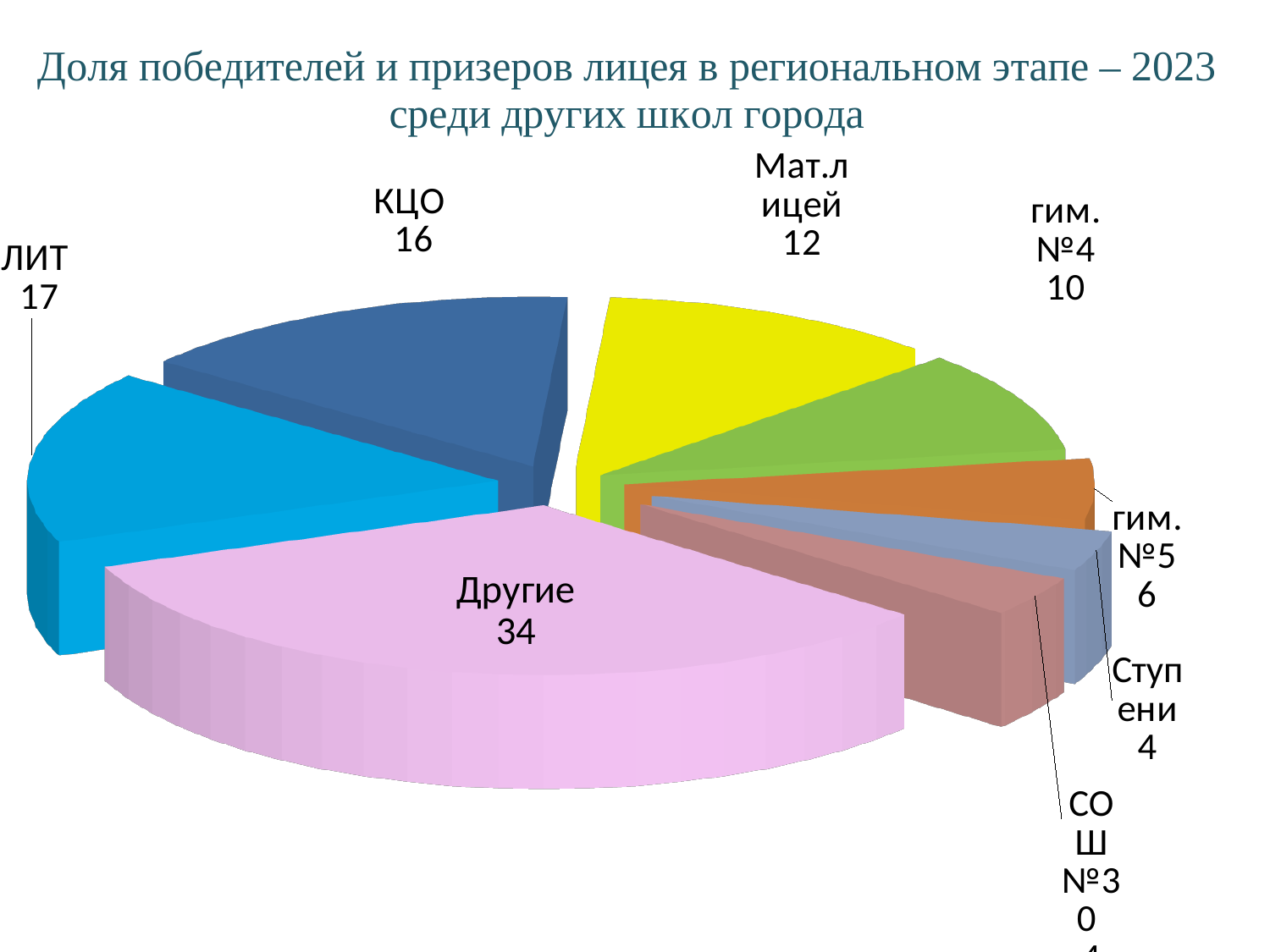
How many slices does the pie chart have? 8 What is the value for гим. №4? 10 What is the value for ЛИТ? 17 What is the value for гим. №5? 6 Which category has the largest slice of the pie? Другие Which is larger, the value for КЦО or the value for Мат.лицей? КЦО What is the value for Ступени? 4 What is the value for КЦО? 16 What is the value for Мат.лицей? 12 What is the difference between the values for Другие and ЛИТ? 17 What is the difference between the values for Мат.лицей and гим. №4? 2 What type of chart is shown on the slide? Pie chart